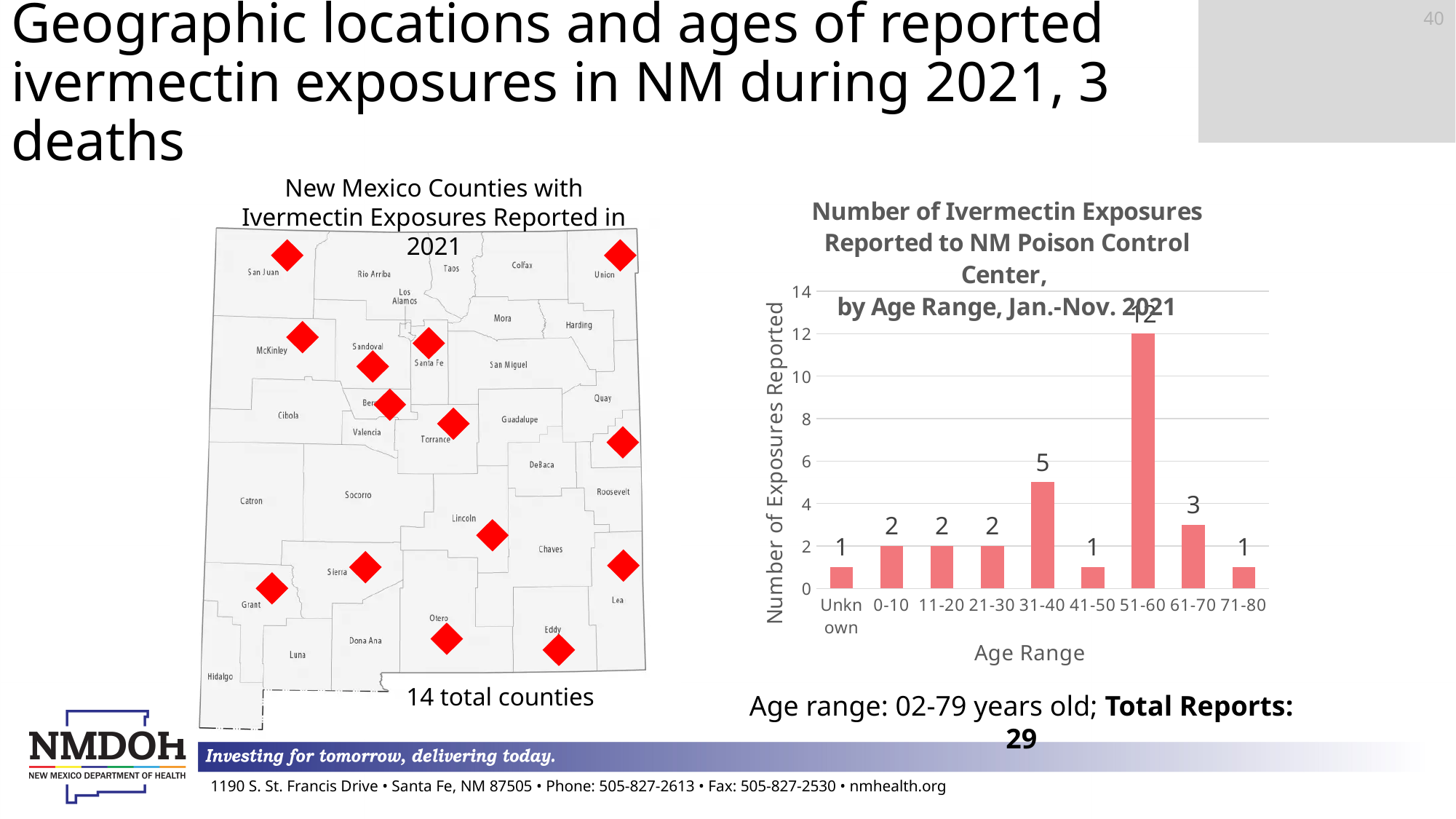
What is the difference in exposures reported between the 51-60 and 31-40 age ranges? 7 Is the value for the 51-60 age range greater or less than 10? greater Which age range has the highest number of exposures reported? 51-60 How many exposures were reported for the 31-40 age range? 5 How many exposures were reported for the 61-70 age range? 3 What kind of chart is used to show the number of ivermectin exposures by age range? bar chart How many age range categories are shown on the x axis of the bar chart? 9 How many exposures were reported for the Unknown age range? 1 Which has more exposures reported, the 61-70 age range or the 0-10 age range? 61-70 How many exposures were reported for the 51-60 age range? 12 What is the label of the y axis of the bar chart? Number of Exposures Reported What is the total number of exposures reported across all age ranges in the bar chart? 29